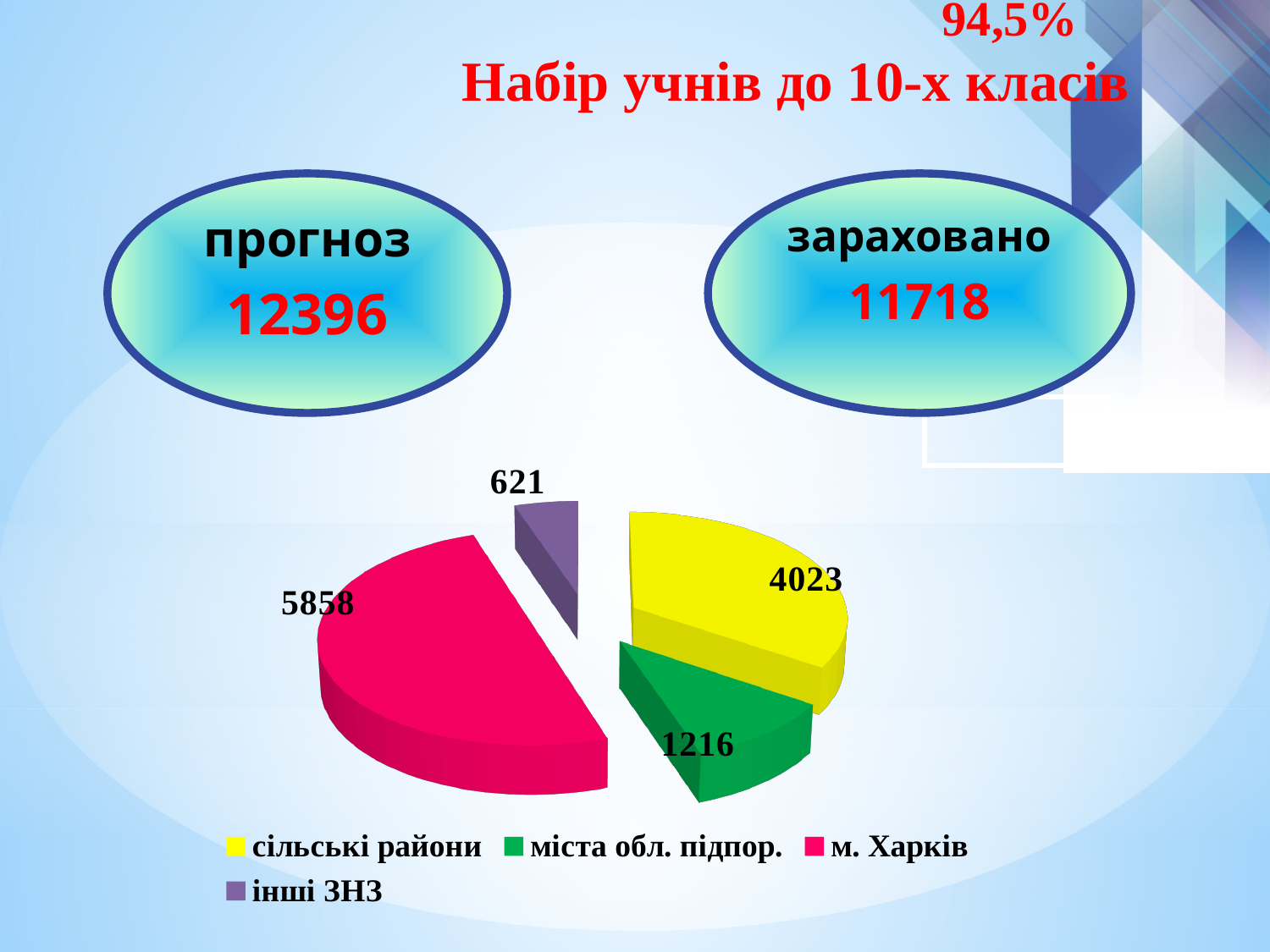
Which category has the largest slice in the pie chart? м. Харків What is the total of all slices in the pie chart? 11718 Which is larger: the value for сільські райони or the value for міста обл. підпор.? сільські райони How many slices does the pie chart have? 4 What is the value for міста обл. підпор. in the pie chart? 1216 What kind of chart is shown on the slide? pie chart What is the difference between the values for м. Харків and сільські райони? 1835 Which category has the smallest slice in the pie chart? інші ЗНЗ What is the value for сільські райони in the pie chart? 4023 What is the value for інші ЗНЗ in the pie chart? 621 What colour is the slice for м. Харків in the pie chart? pink What is the value for м. Харків in the pie chart? 5858